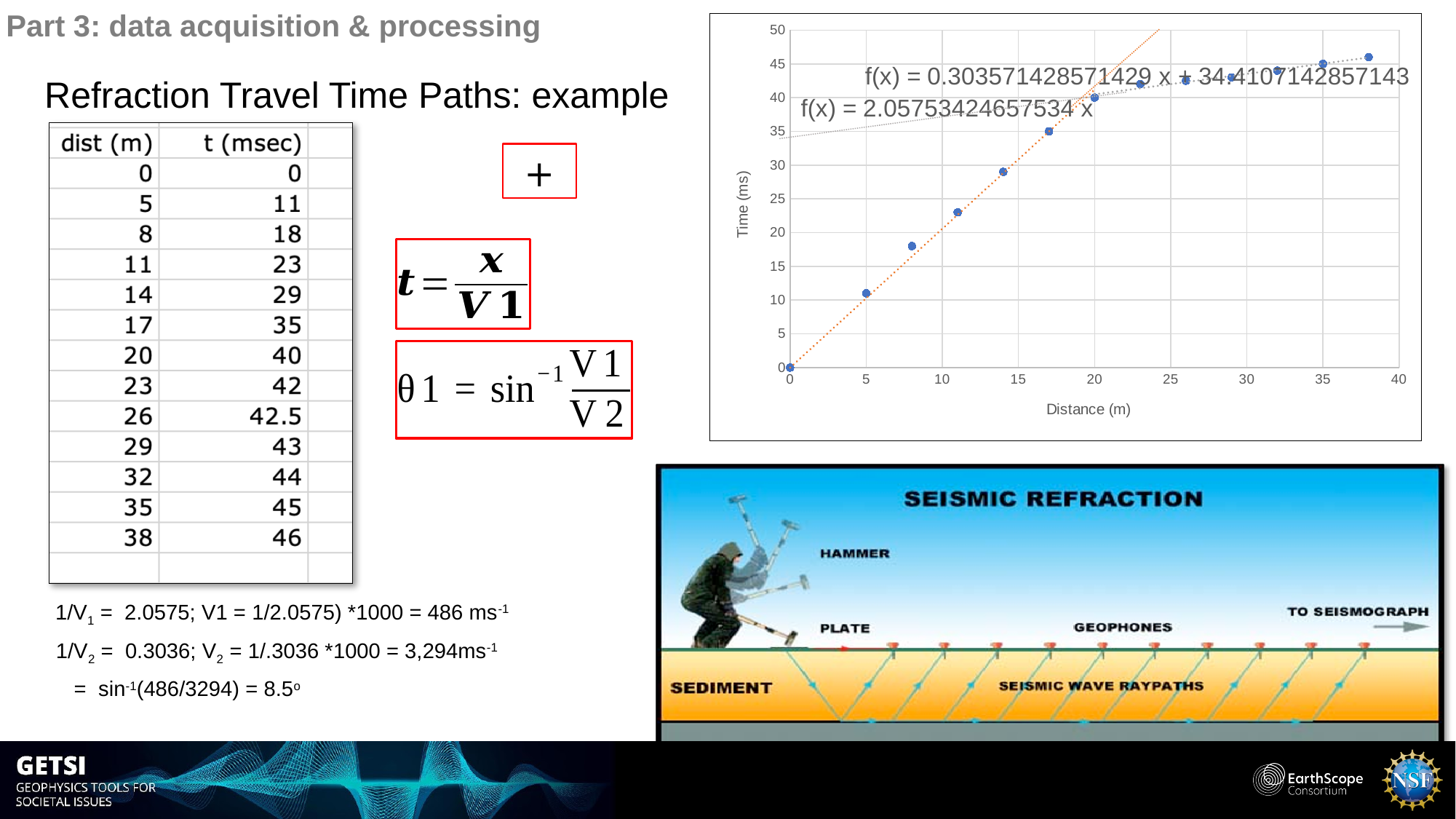
What is the time value plotted at a distance of 0 m? 0 Is the time value plotted at a distance of 11 m greater or less than 20? greater What is the title of the x axis of the chart? Distance (m) Do the plotted time values rise or fall as distance increases along the x axis? rise Which has the larger plotted time value: the point at 14 m or the point at 23 m? 23 m Is the time value plotted at a distance of 5 m greater or less than 15? less How many data points are plotted on the chart? 13 What is the time value plotted at a distance of 35 m? 45 At which distance is the plotted time value highest? 38 What is the title of the y axis of the chart? Time (ms) What kind of chart is shown on the slide? scatter chart What is the time value plotted at a distance of 20 m? 40